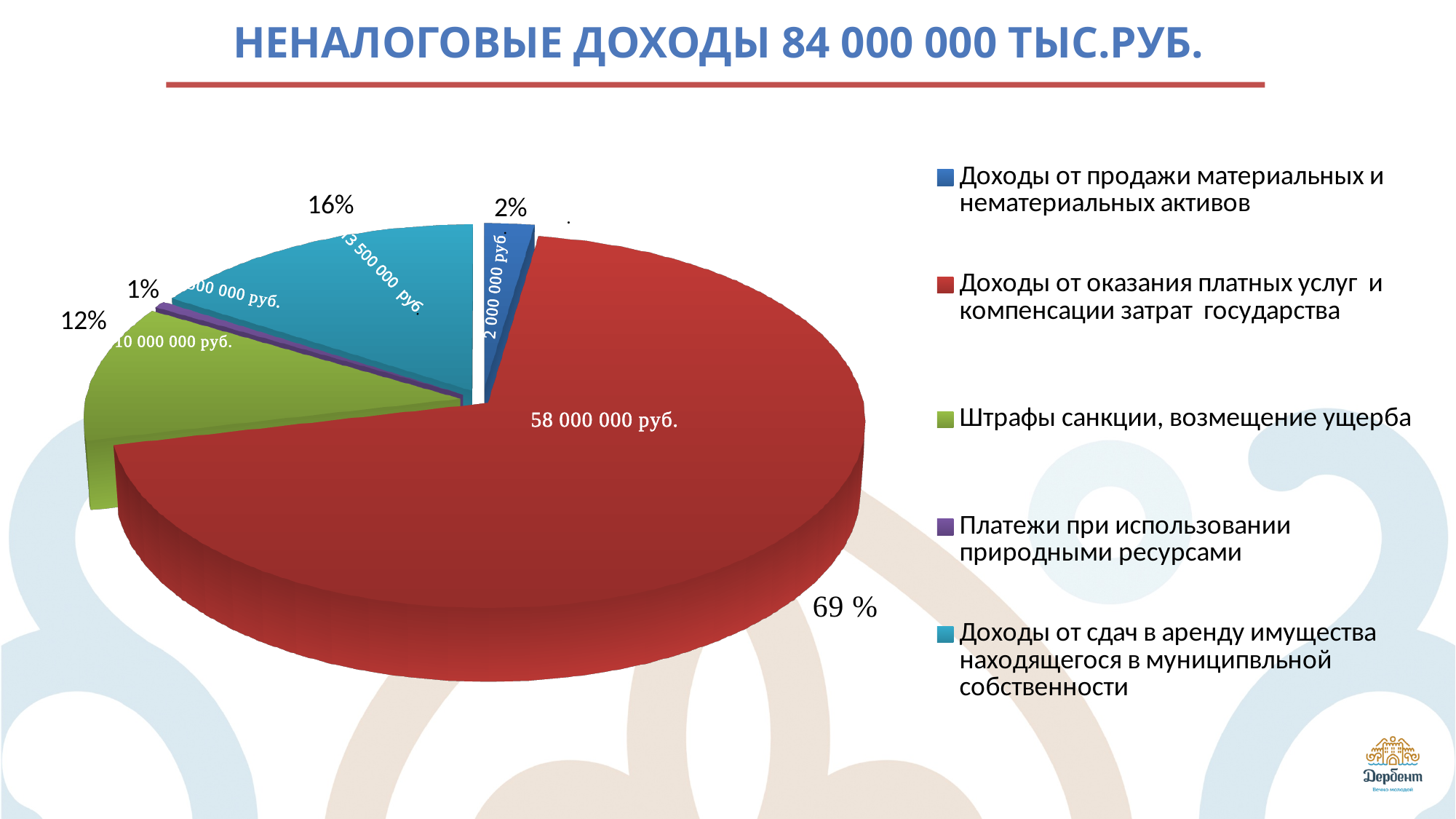
What share of the pie is labelled for 'Доходы от оказания платных услуг и компенсации затрат государства'? 69 % How many entries does the legend list? 5 What value is printed on the red slice 'Доходы от оказания платных услуг и компенсации затрат государства'? 58 000 000 руб. What share of the pie is labelled for 'Штрафы санкции, возмещение ущерба'? 12% What share of the pie is labelled for 'Доходы от сдач в аренду имущества находящегося в муниципвльной собственности'? 16% What value is printed on the blue slice 'Доходы от продажи материальных и нематериальных активов'? 2 000 000 руб. Which category has the smallest slice of the pie? Платежи при использовании природными ресурсами Which category has the largest slice of the pie? Доходы от оказания платных услуг и компенсации затрат государства What kind of chart is shown on the slide? Pie chart What is the title of the chart on the slide? НЕНАЛОГОВЫЕ ДОХОДЫ 84 000 000 ТЫС.РУБ. How many slices does the pie chart have? 5